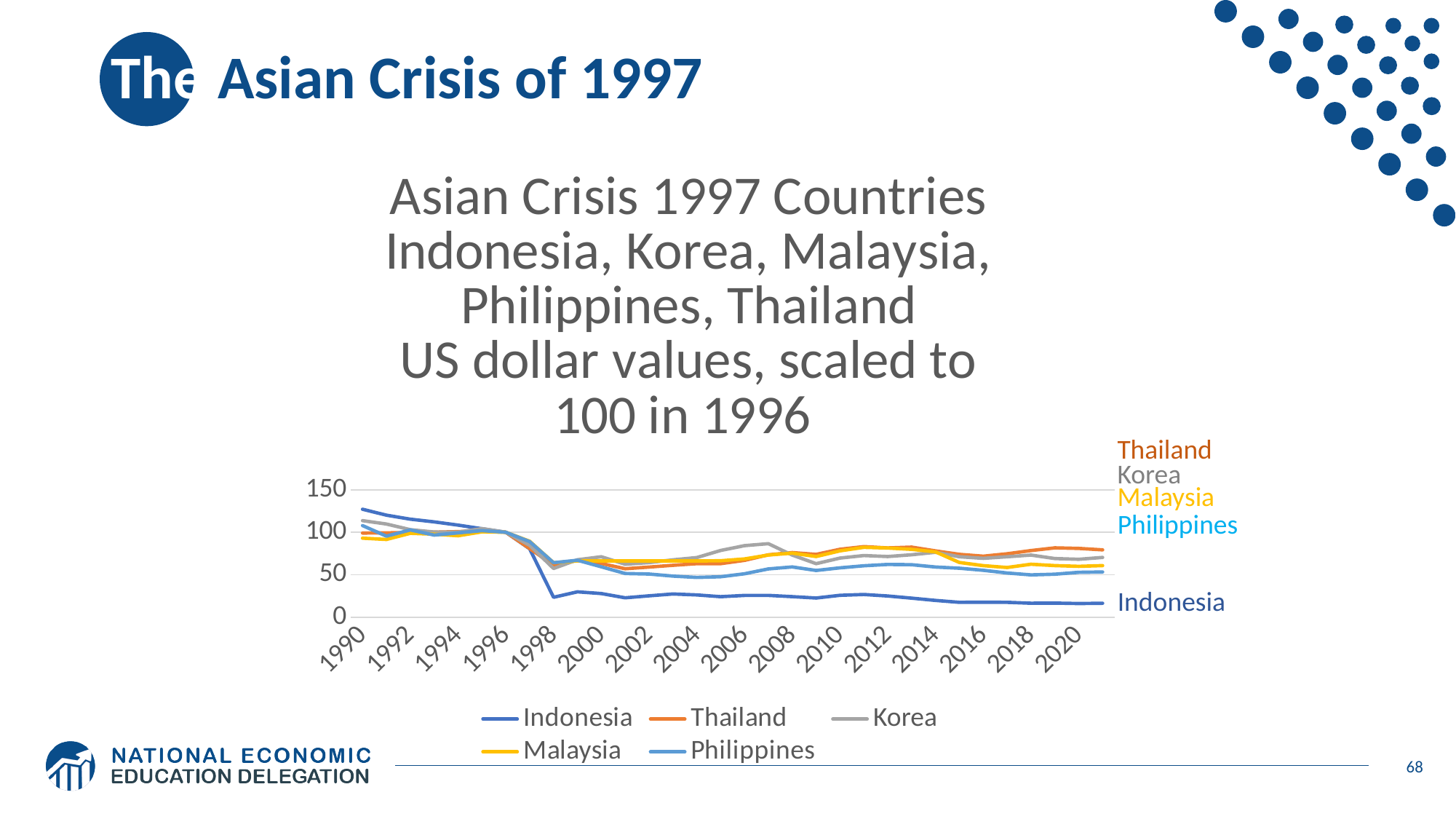
Is the value for Indonesia in 2020 greater or less than 50? less Is the value for Indonesia in 1990 greater or less than 100? greater Which country has the lowest value in 2020? Indonesia Which is larger in 2020, the value for Thailand or the value for Indonesia? Thailand Which country has the highest value in 1990? Indonesia What is the value for Indonesia in 1996? 100 How many series does the legend list? 5 What kind of chart is shown on the slide? line chart Which countries are listed in the chart legend? Indonesia, Thailand, Korea, Malaysia, Philippines According to the chart title, to what value are the series scaled in 1996? 100 Does the value for Indonesia rise or fall from 1990 to 2020? fall Is the value for Thailand in 2020 greater or less than 50? greater